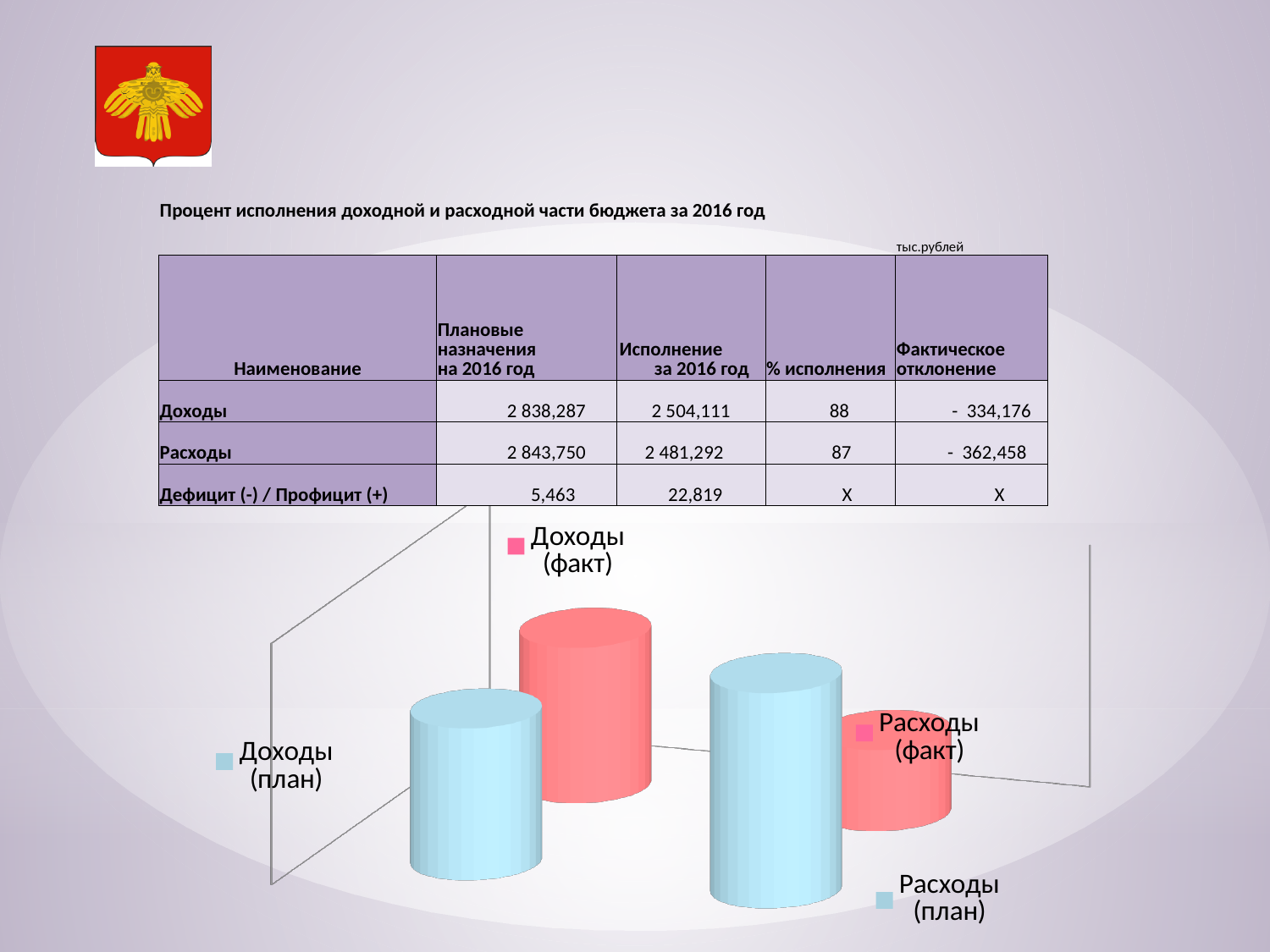
What colour are the Доходы (факт) and Расходы (факт) bars in the chart? pink/red What kind of chart is shown at the bottom of the slide? bar chart Which bar is taller in the chart, Доходы (план) or Расходы (факт)? Доходы (план) Which bar in the chart is the shortest? Расходы (факт) How many bars are plotted in the chart? 4 What colour are the Доходы (план) and Расходы (план) bars in the chart? light blue